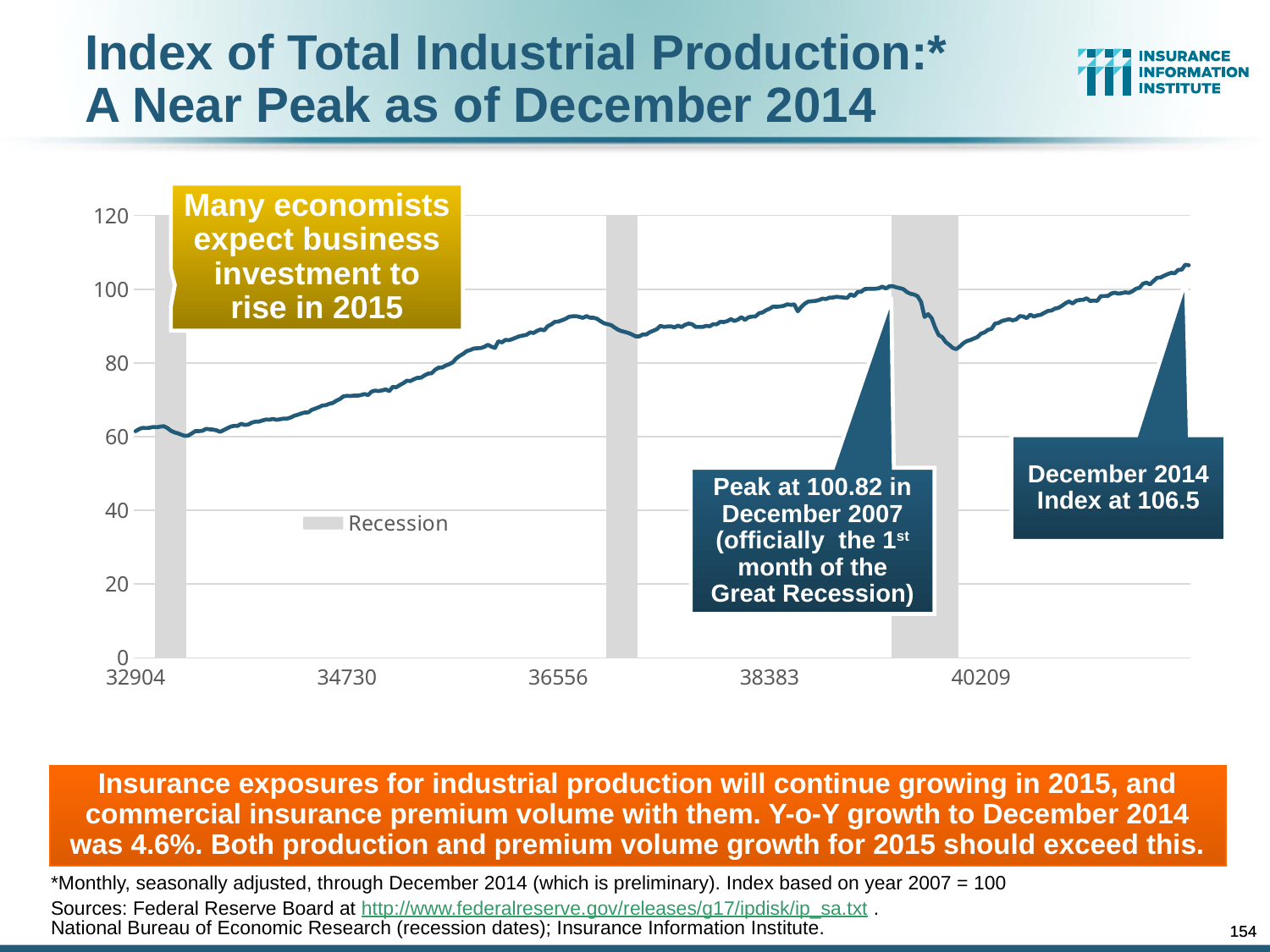
Is the index value at the start of the series (x = 32904) greater or less than 80? less What kind of chart is shown on the slide? line chart Which is higher, the index in December 2007 or in December 2014? December 2014 What is the only entry shown in the chart's legend? Recession Over the whole period shown, does the index generally rise or fall along the x axis? rise By how much does the December 2014 index value exceed the December 2007 peak? 5.68 How many grey shaded recession bands are shown on the chart? 3 What was the peak value of the index in December 2007? 100.82 What was the Index of Total Industrial Production in December 2014? 106.5 What is the highest value shown on the y axis? 120 Is the index value at x = 36556 greater or less than 100? less